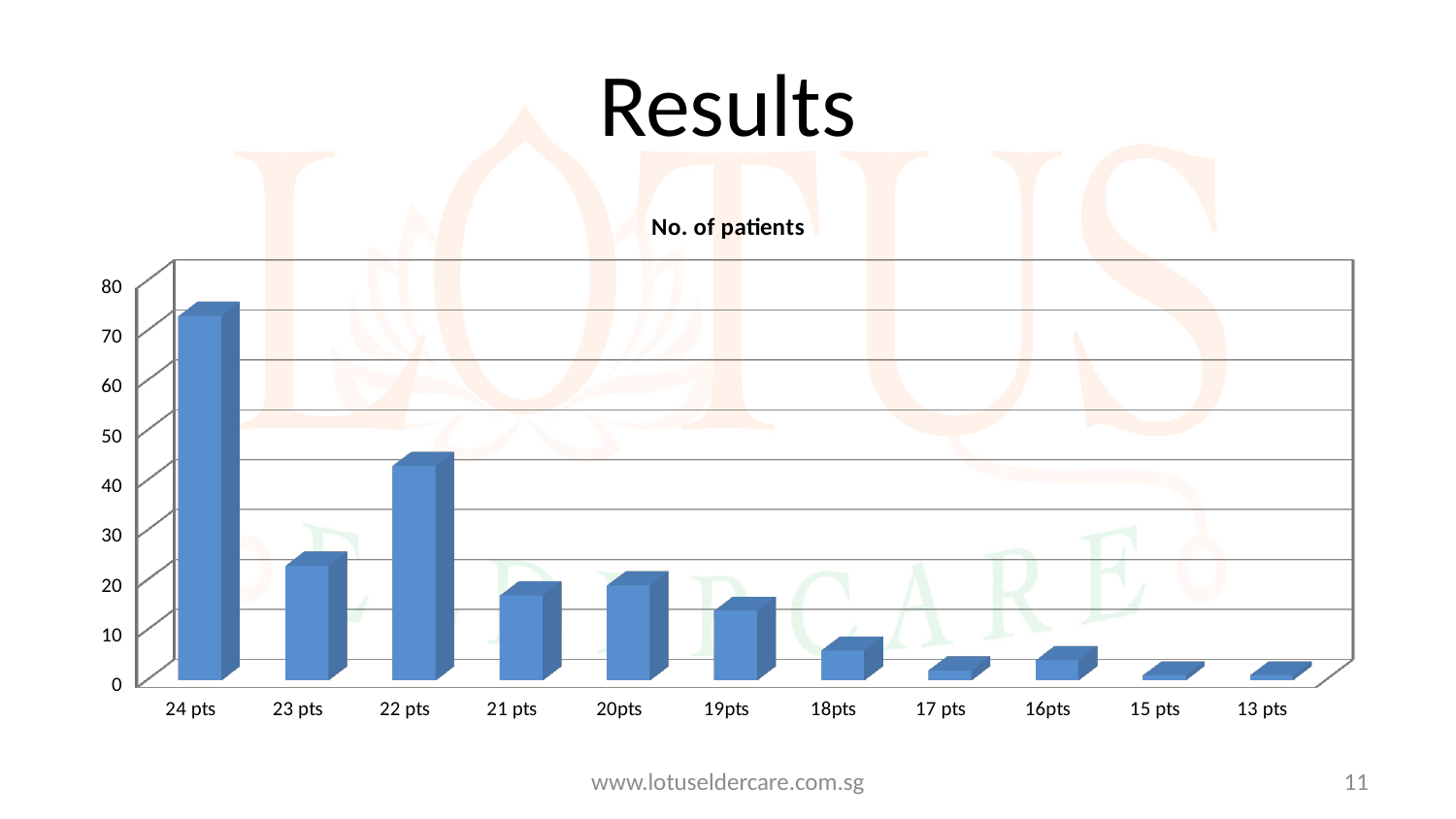
Is the value for 18pts greater or less than 10? less Is the value for 23 pts greater or less than 30? less Is the value for 22 pts greater or less than 30? greater What is the title of the chart? No. of patients Which has more patients, 22 pts or 23 pts? 22 pts Which category has the highest number of patients? 24 pts Which has more patients, 19pts or 18pts? 19pts What type of chart is shown on the slide? bar chart Which category is the leftmost on the x axis? 24 pts How many categories are shown on the x axis of the chart? 11